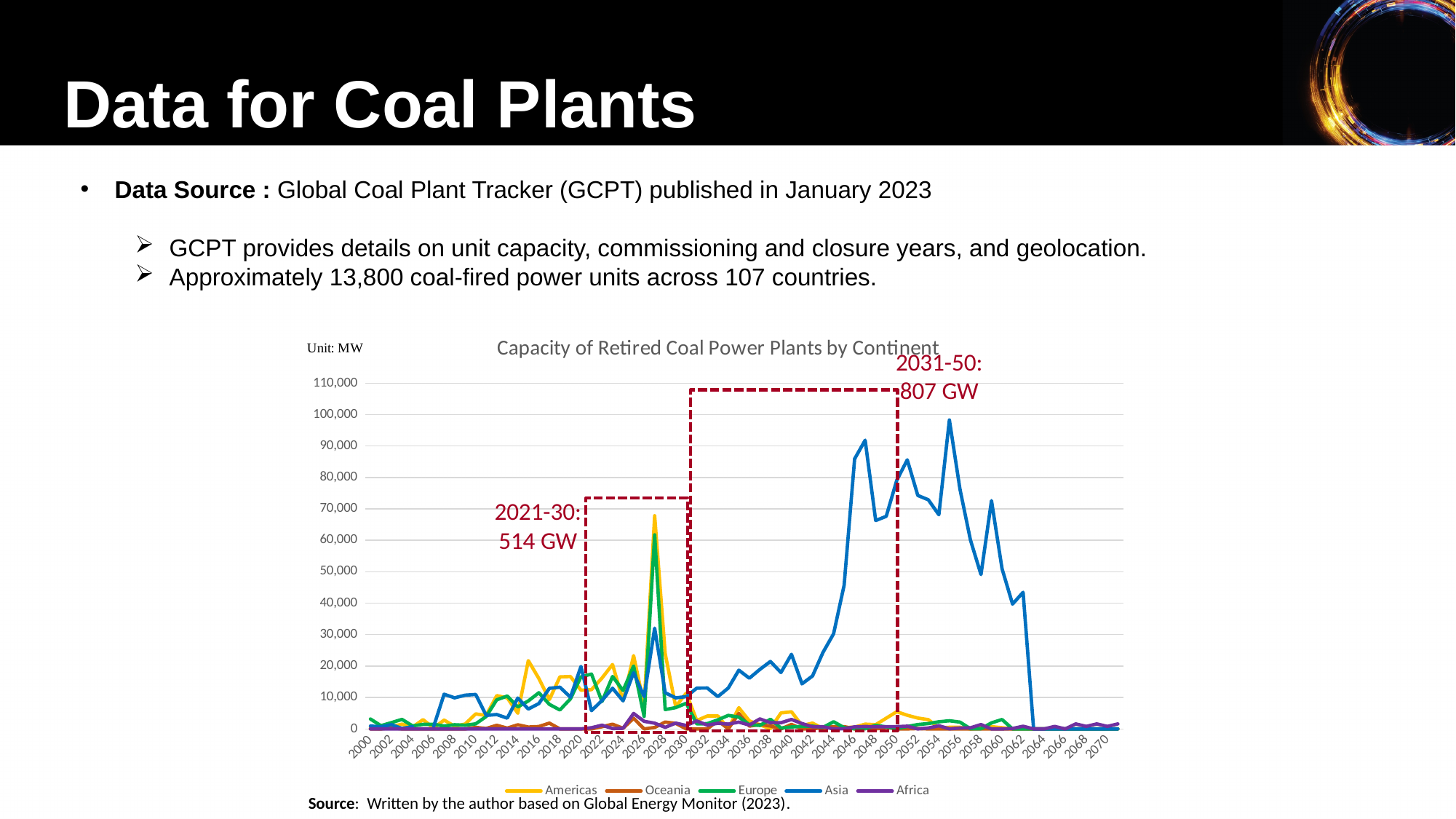
Is the peak value of the Asia line around 2056 greater or less than 90,000? greater Does the Asia line rise or fall between 2056 and 2063? fall What kind of chart is shown on the slide? line chart What is the difference between the annotated capacities for 2031-50 and 2021-30? 293 GW What is the title of the chart? Capacity of Retired Coal Power Plants by Continent What total retired capacity is annotated for the period 2021-30? 514 GW What total retired capacity is annotated for the period 2031-50? 807 GW Which annotated period has the larger retired capacity, 2021-30 or 2031-50? 2031-50 How many series does the legend of the chart list? 5 Is the peak value of the Americas line around 2027 greater or less than 60,000? greater What unit is stated for the values in the chart? MW Which continent's line reaches the highest value anywhere on the chart? Asia